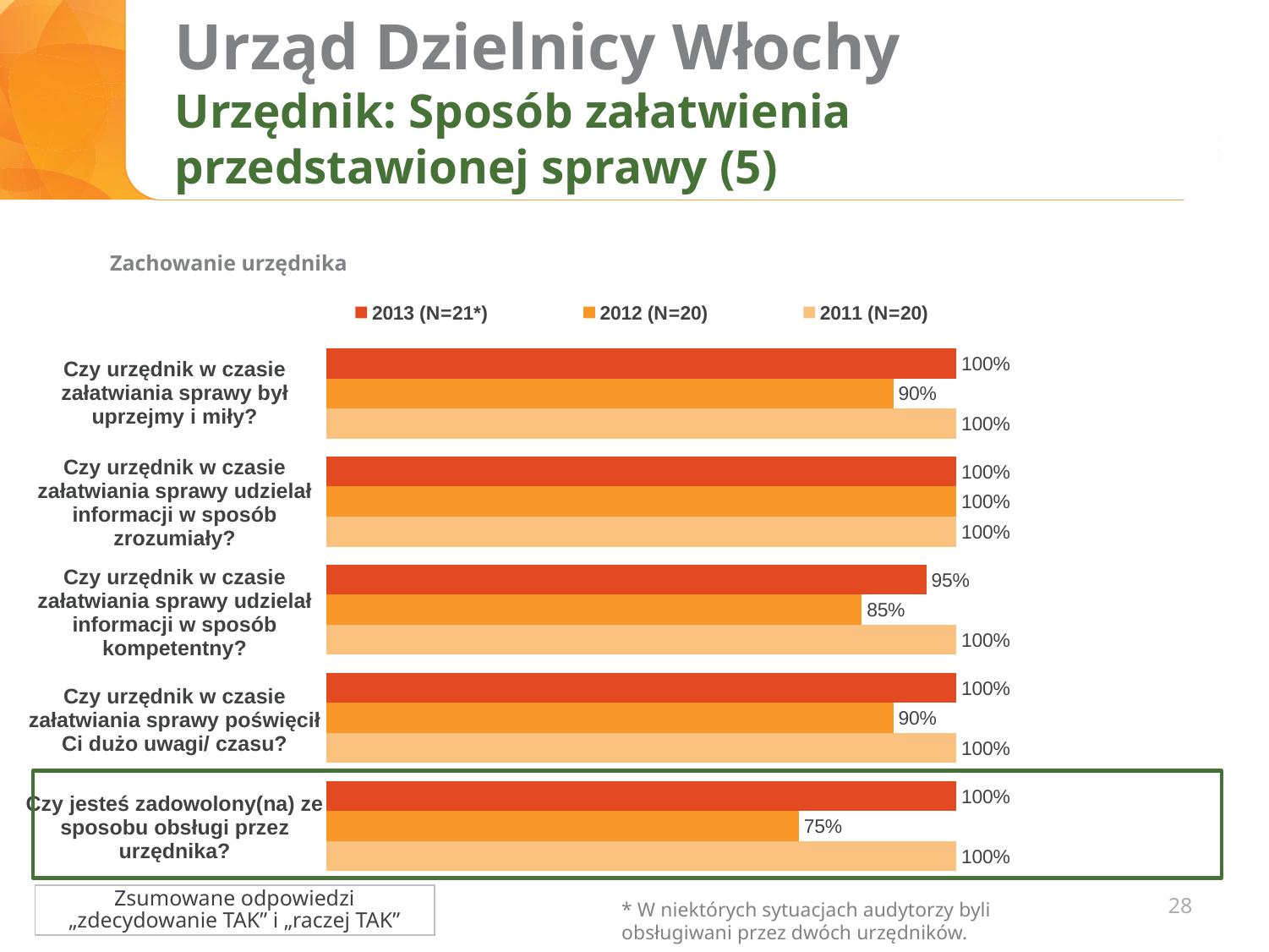
Which category has the lowest 2013 (N=21*) value? Czy urzędnik w czasie załatwiania sprawy udzielał informacji w sposób kompetentny? What is the 2011 (N=20) value for "Czy urzędnik w czasie załatwiania sprawy poświęcił Ci dużo uwagi/ czasu?"? 100% What is the 2012 (N=20) value for "Czy jesteś zadowolony(na) ze sposobu obsługi przez urzędnika?"? 75% Which category has the lowest 2012 (N=20) value? Czy jesteś zadowolony(na) ze sposobu obsługi przez urzędnika? What is the difference between the 2011 (N=20) and 2012 (N=20) values for "Czy urzędnik w czasie załatwiania sprawy udzielał informacji w sposób kompetentny?"? 15% How many series does the legend list? 3 How many question categories are shown in the chart? 5 What is the difference between the 2013 (N=21*) and 2012 (N=20) values for "Czy jesteś zadowolony(na) ze sposobu obsługi przez urzędnika?"? 25% What is the 2013 (N=21*) value for "Czy urzędnik w czasie załatwiania sprawy udzielał informacji w sposób kompetentny?"? 95% What kind of chart is shown on the slide? Bar chart For "Czy urzędnik w czasie załatwiania sprawy udzielał informacji w sposób kompetentny?", which is larger: the 2013 (N=21*) value or the 2012 (N=20) value? 2013 (N=21*) What is the 2012 (N=20) value for "Czy urzędnik w czasie załatwiania sprawy był uprzejmy i miły?"? 90%